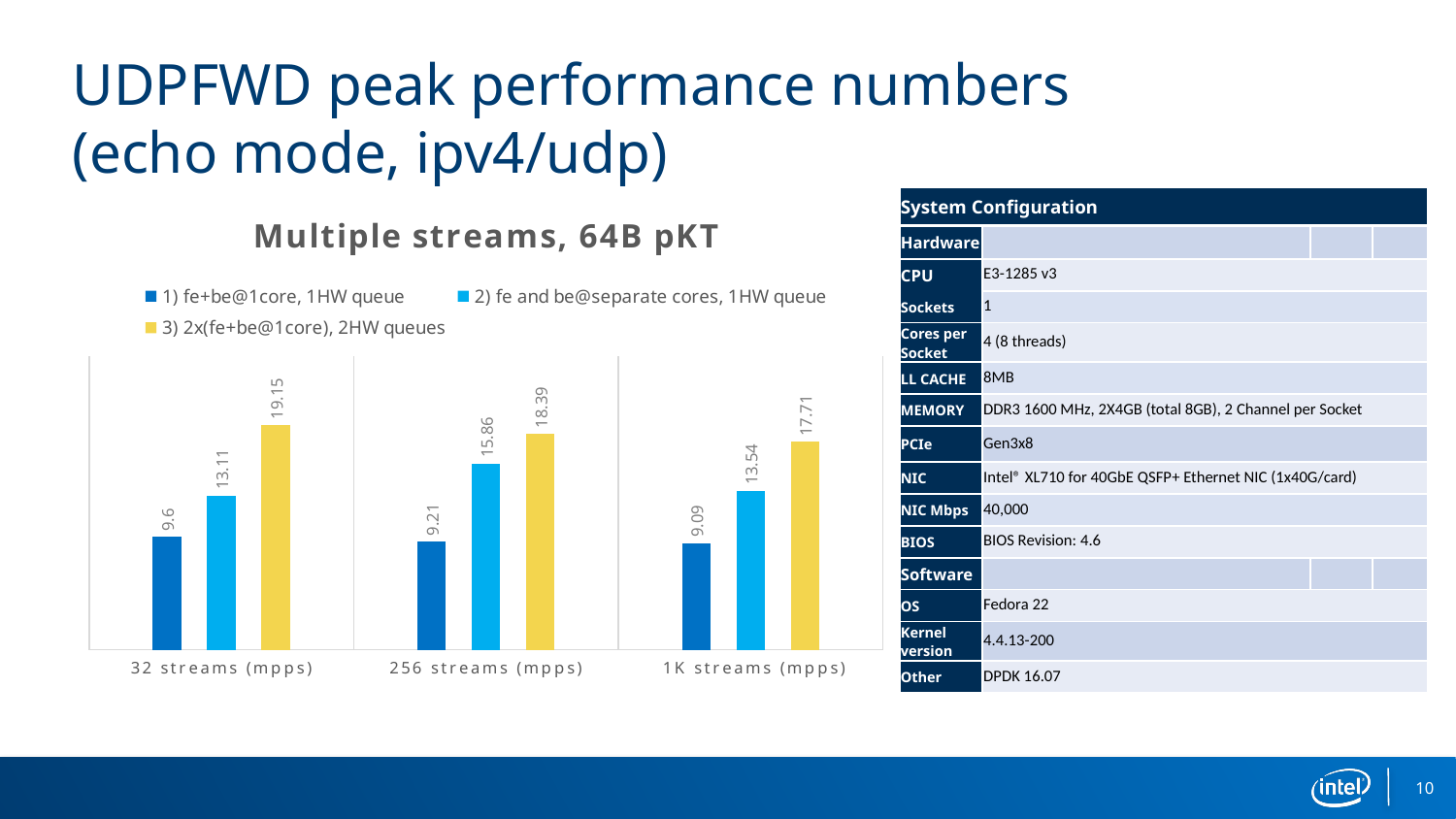
Which is larger: series "2) fe and be@separate cores, 1HW queue" at 256 streams or at 1K streams? 256 streams (mpps) What is the value for series "3) 2x(fe+be@1core), 2HW queues" at 256 streams (mpps)? 18.39 Do the values for series "3) 2x(fe+be@1core), 2HW queues" rise or fall from 32 streams to 1K streams? fall What is the value for series "2) fe and be@separate cores, 1HW queue" at 1K streams (mpps)? 13.54 Which category has the highest value for series "3) 2x(fe+be@1core), 2HW queues"? 32 streams (mpps) What is the value for series "1) fe+be@1core, 1HW queue" at 32 streams (mpps)? 9.6 What kind of chart is shown on the slide? bar chart What is the title of the chart? Multiple streams, 64B pKT Which category has the lowest value for series "1) fe+be@1core, 1HW queue"? 1K streams (mpps) How many series does the legend list? 3 What is the difference between series 3 and series 1 at 32 streams (mpps)? 9.55 How many categories are shown on the x axis? 3